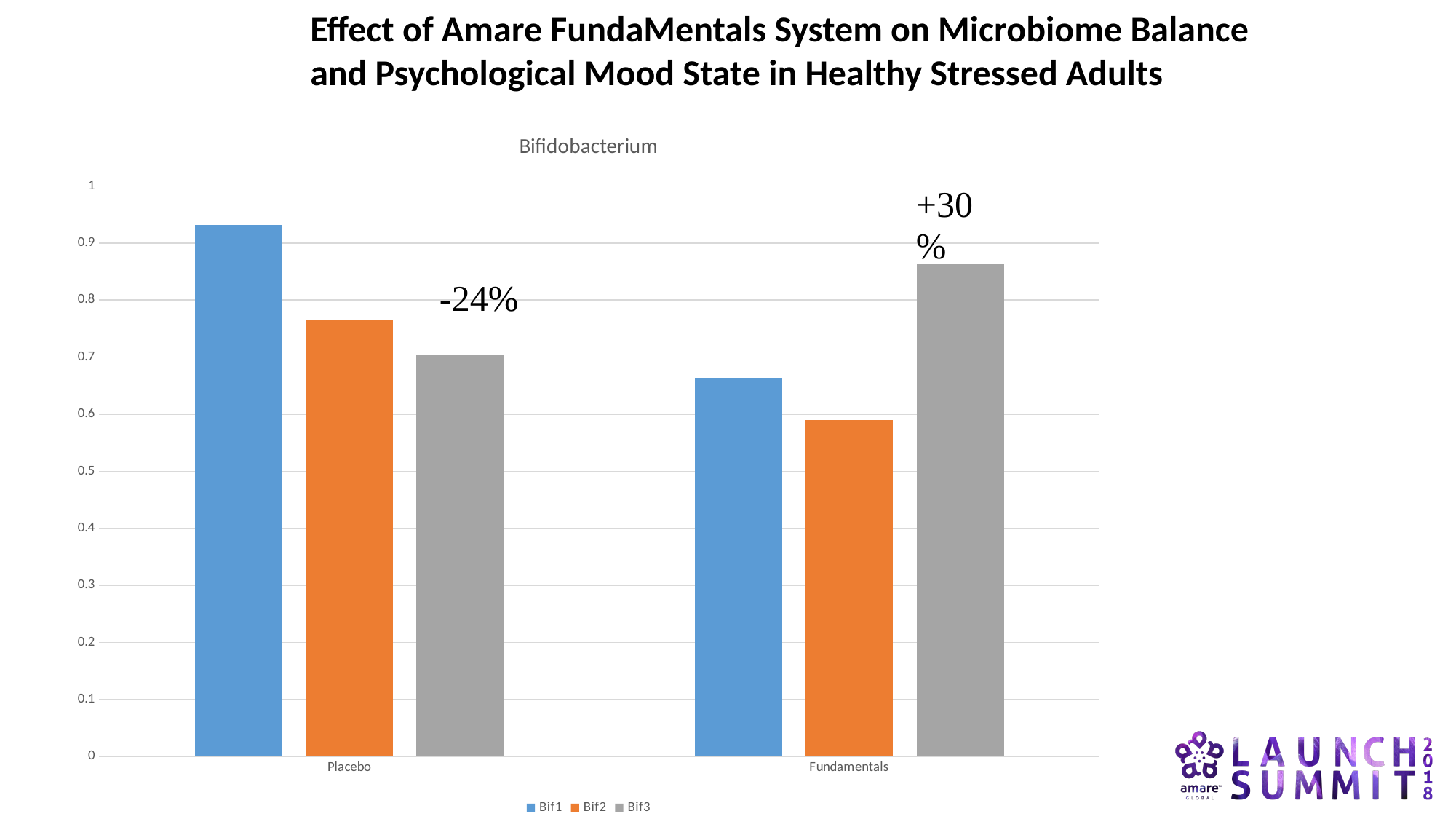
Is the Bif3 value for Fundamentals greater or less than 0.9? less What type of chart is shown on the slide? Bar chart Is the Bif1 value for Placebo greater or less than 0.9? greater How many categories are shown on the x axis? 2 Which series has the tallest bar in the Placebo group? Bif1 What is the title of the chart? Bifidobacterium What percentage change is annotated above the Fundamentals group? +30% Which series has the tallest bar in the Fundamentals group? Bif3 What percentage change is annotated above the Placebo group? -24% Which is larger, the Bif1 value for Placebo or the Bif1 value for Fundamentals? Placebo How many series does the legend list? 3 Which series has the lowest bar in the Fundamentals group? Bif2